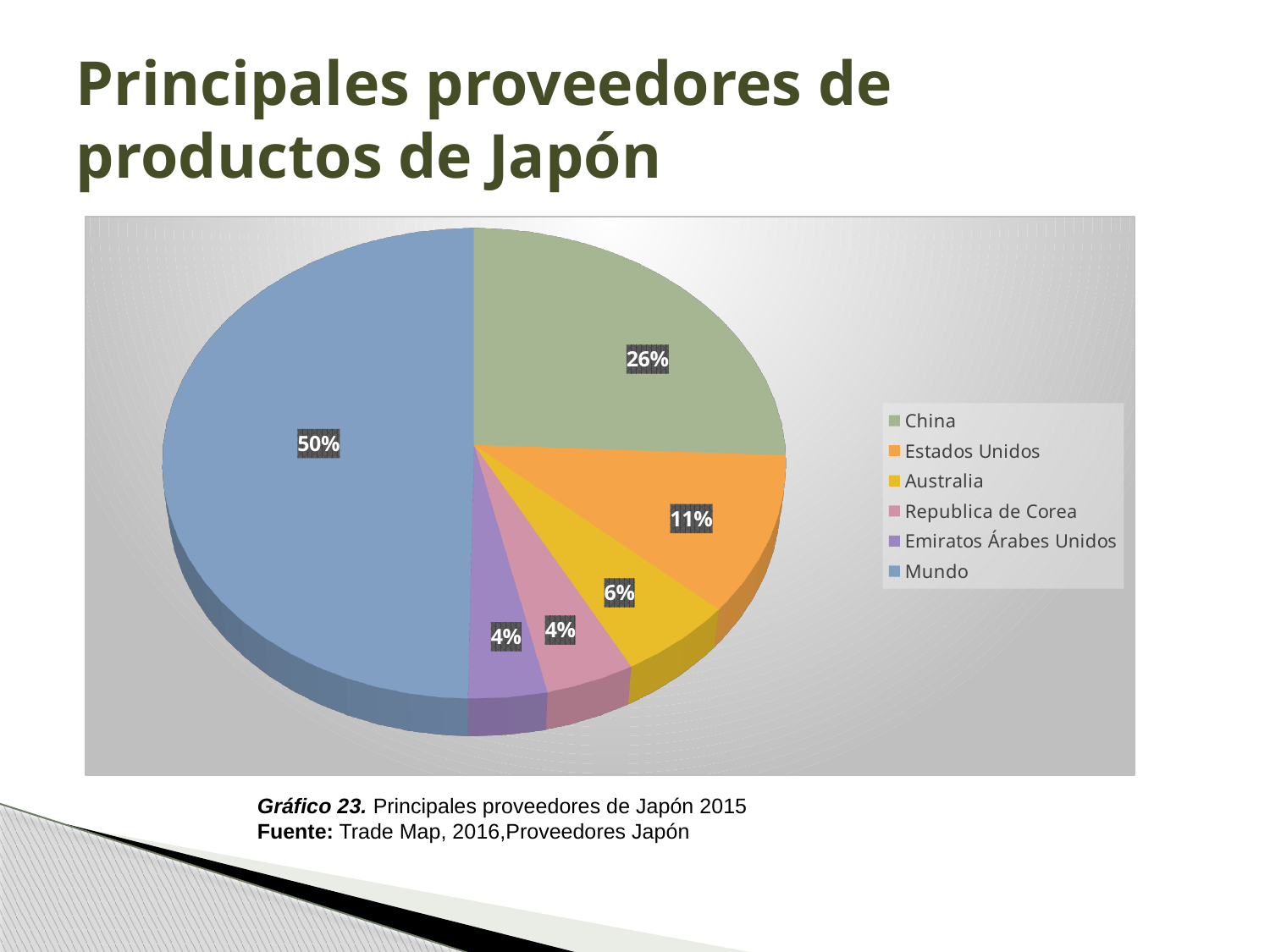
What share of the pie does China represent? 26% Which category has the largest slice of the pie? Mundo Which legend entry is shown in blue? Mundo What kind of chart is shown on the slide? Pie chart What is the difference between the values for China and Estados Unidos? 15% Which is larger, the value for Australia or the value for Emiratos Árabes Unidos? Australia What is the value shown for Australia? 6% How many slices does the pie chart have? 6 What is the value shown for Estados Unidos? 11% What is the value shown for Republica de Corea? 4% What is the difference between the values for Mundo and China? 24% What share of the pie does Mundo represent? 50%